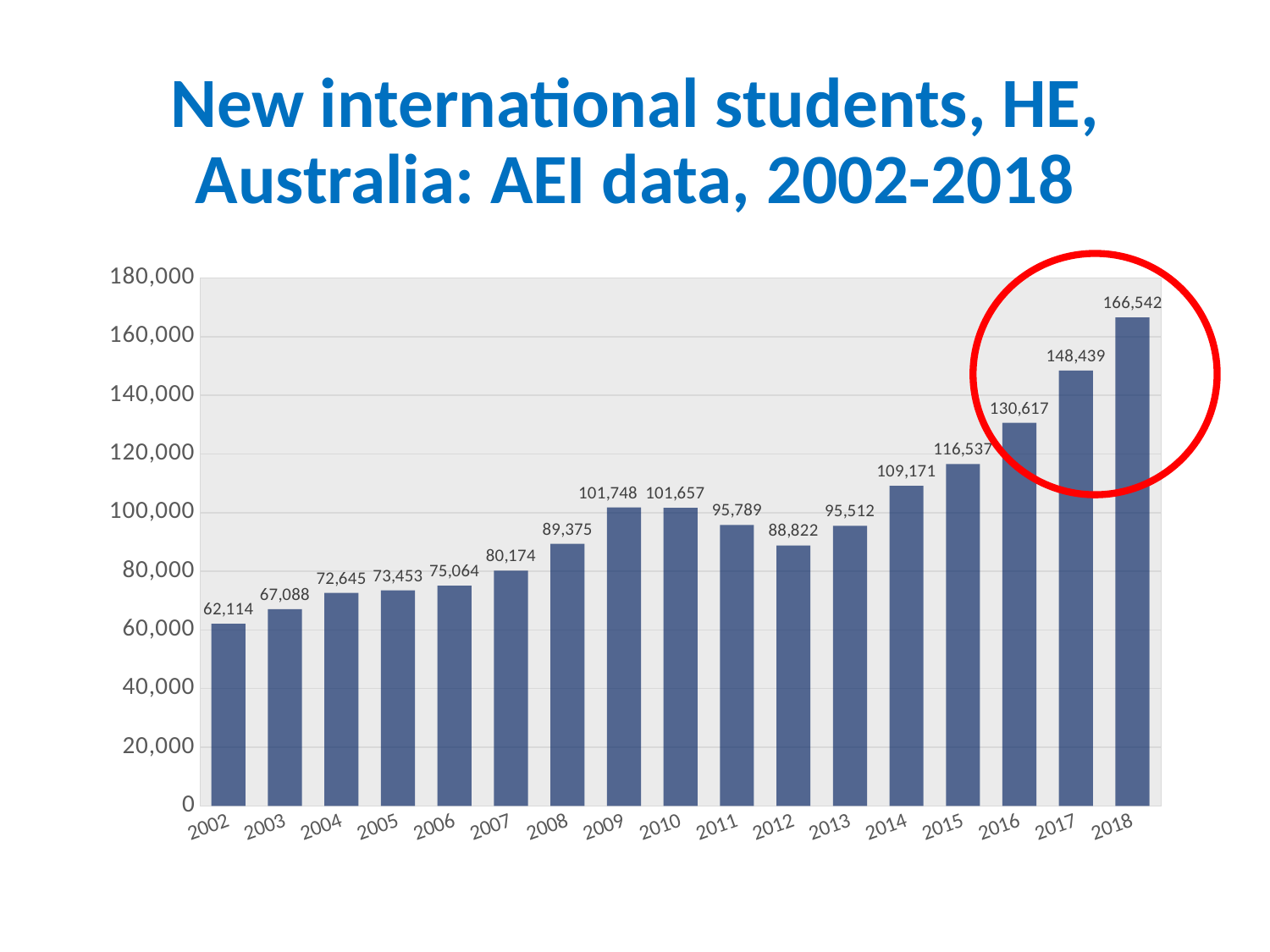
Which year has the highest value? 2018 What is the difference between the values for 2016 and 2015? 14,080 What is the value for 2018? 166,542 What is the difference between the values for 2018 and 2017? 18,103 Is the value for 2014 greater or less than 100,000? greater What kind of chart is shown on the slide? bar chart Which is larger, the value for 2011 or the value for 2013? 2011 What is the value for 2002? 62,114 Which year has the lowest value? 2002 How many years are shown on the x axis? 17 What is the value for 2012? 88,822 Do the values generally rise or fall from 2013 to 2018? rise